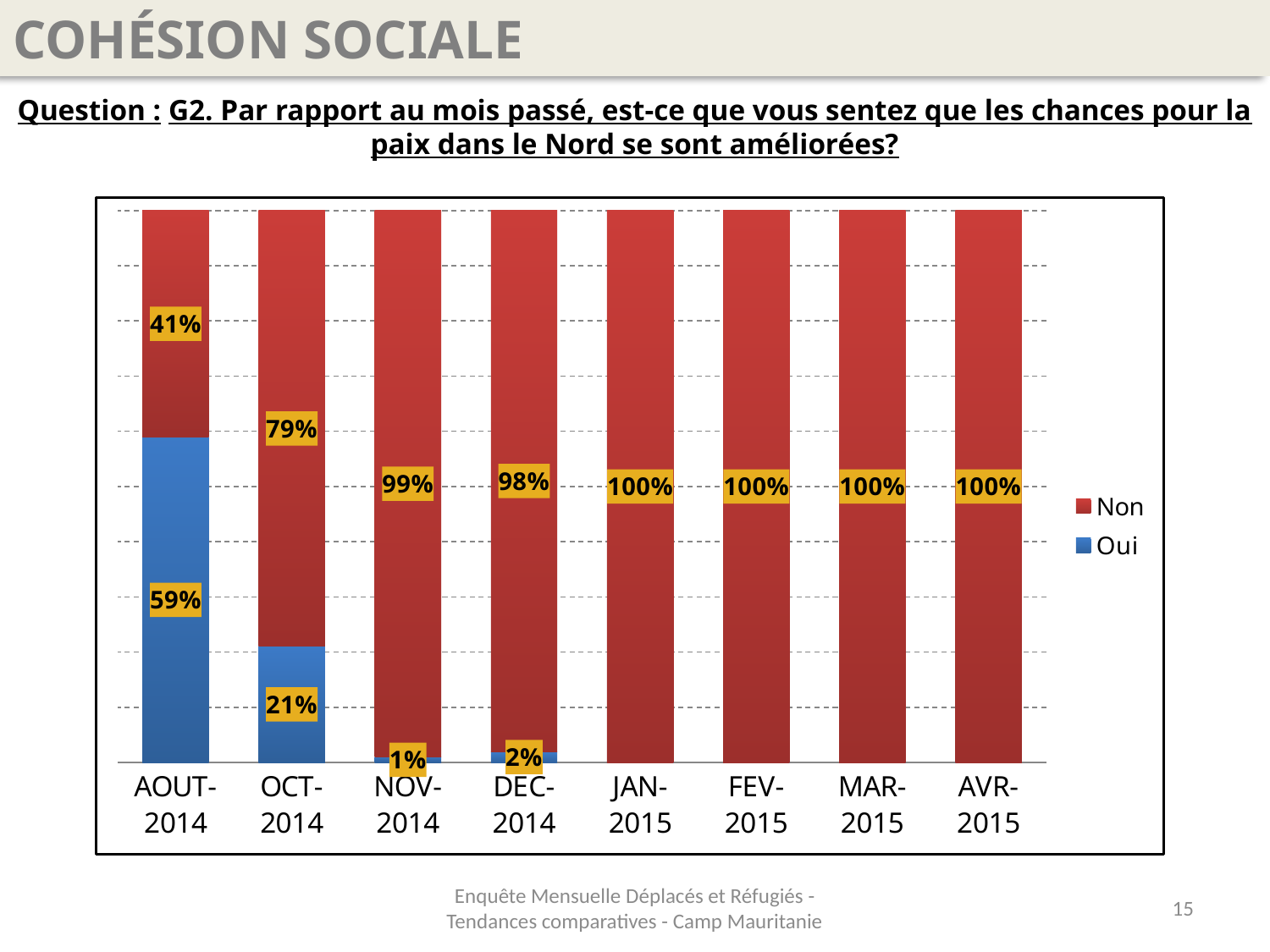
What is the value for Non in NOV-2014? 99% What kind of chart is shown on the slide? Stacked bar chart Does the Non value rise or fall from AOUT-2014 to JAN-2015? Rise How many months are shown on the x axis? 8 In which month is the Oui value highest? AOUT-2014 What is the value for Oui in DEC-2014? 2% How many series does the legend list? 2 In which month is the Non value lowest? AOUT-2014 What is the difference between the Non values for OCT-2014 and AOUT-2014? 38% What is the value for Oui in OCT-2014? 21% Which is larger, the Oui value for AOUT-2014 or the Oui value for OCT-2014? AOUT-2014 What is the value for Non in AOUT-2014? 41%